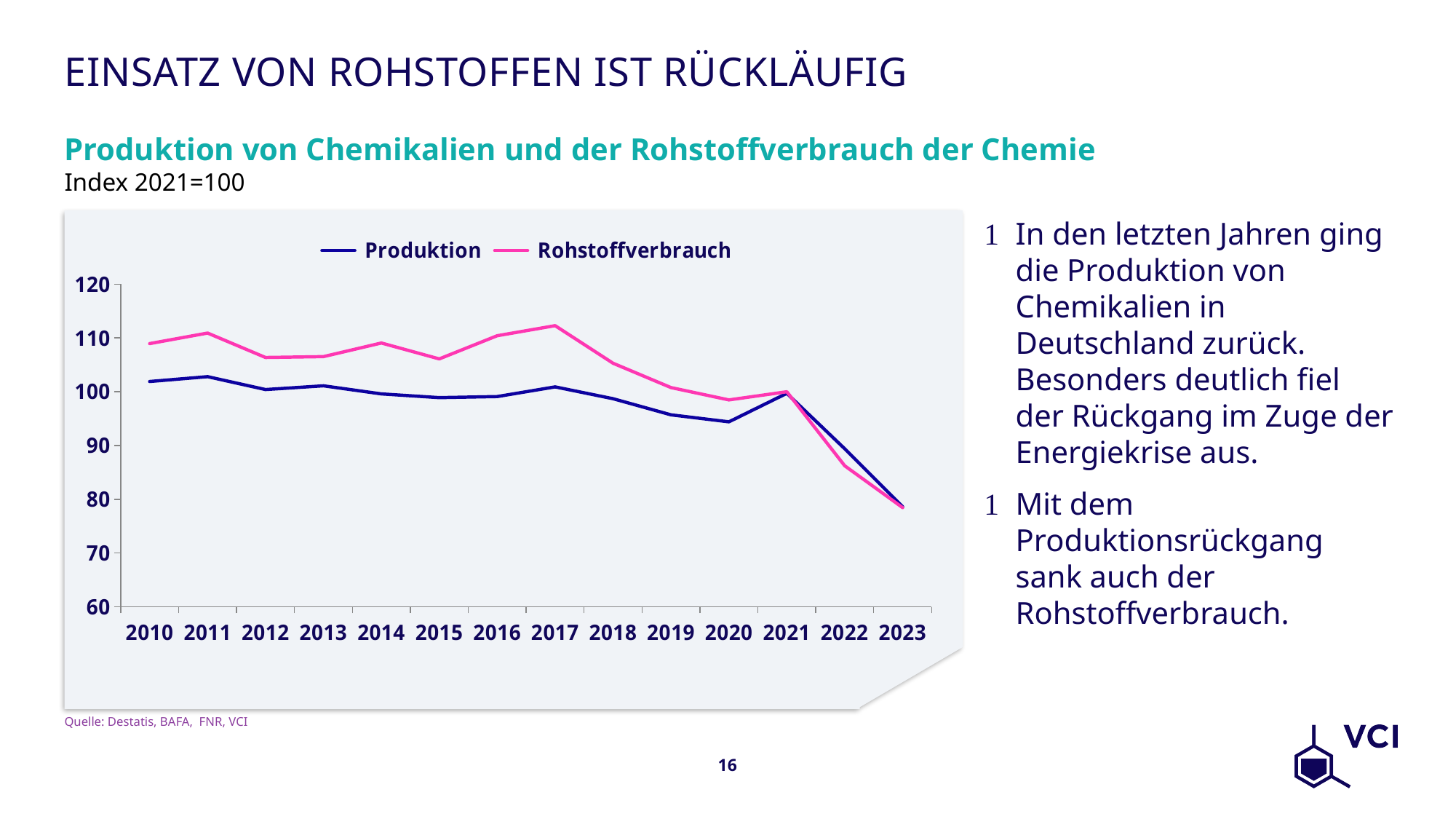
Is the value for Rohstoffverbrauch in 2022 greater or less than 90? less Is the value for Rohstoffverbrauch in 2017 greater or less than 110? greater How many years are plotted along the x axis? 14 How many series does the legend list? 2 What kind of chart is shown on the slide? line chart What is the title of the chart? Produktion von Chemikalien und der Rohstoffverbrauch der Chemie In 2010, which series has the higher value, Produktion or Rohstoffverbrauch? Rohstoffverbrauch Does Produktion rise or fall overall from 2010 to 2023? fall In which year is Rohstoffverbrauch at its highest? 2017 Is the value for Produktion in 2020 greater or less than 100? less In which year is Produktion at its lowest? 2023